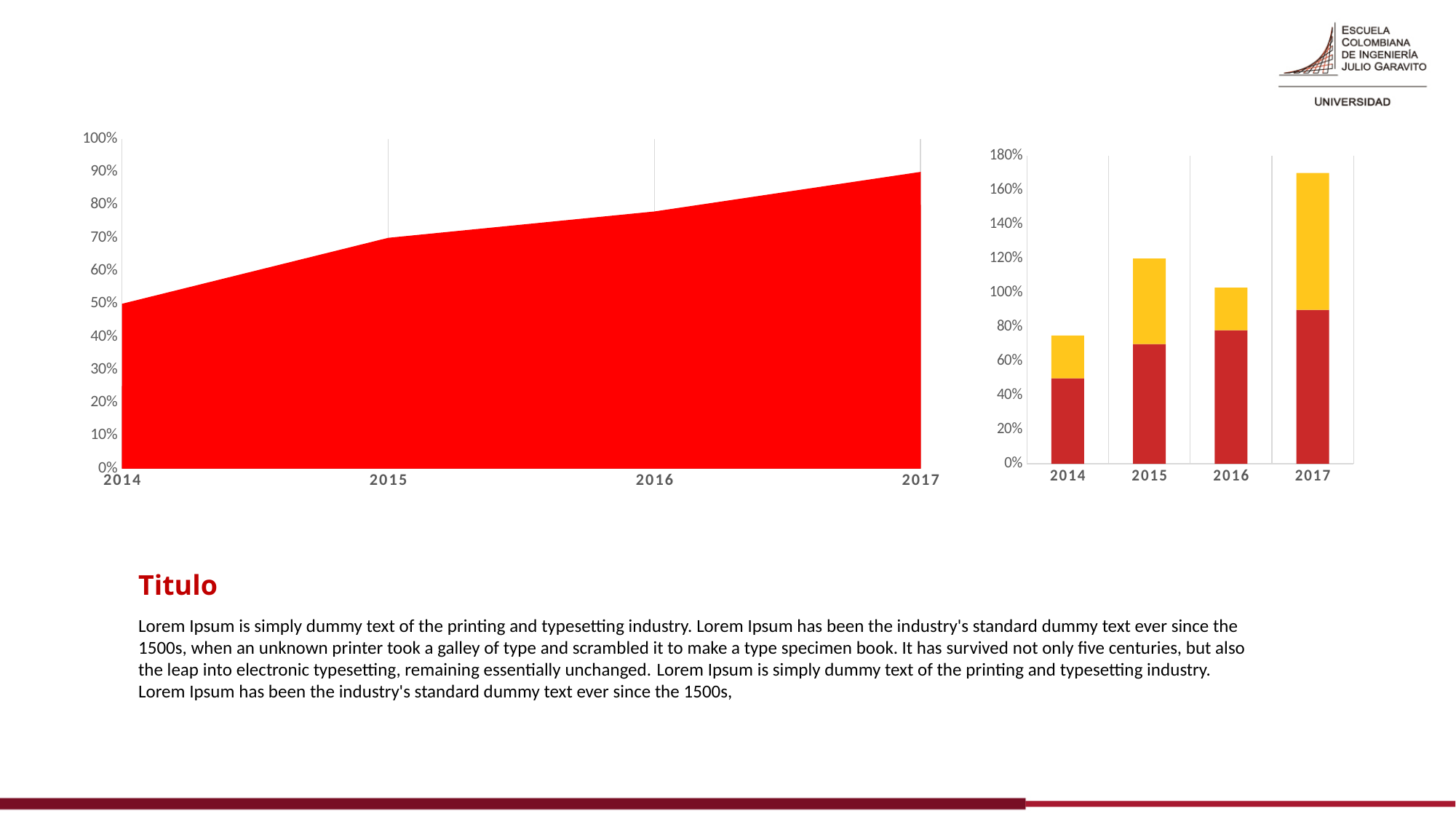
In the left area chart, is the value for 2015 greater or less than 80%? less In the right stacked bar chart, which bar is taller, 2015 or 2016? 2015 How many years are shown on the x axis of the left area chart? 4 What kind of chart is the chart on the left of the slide? area chart In the left area chart, is the value for 2017 greater or less than 80%? greater In the left area chart, do the values rise or fall from 2014 to 2017? rise How many bars are there in the right stacked bar chart? 4 In the right stacked bar chart, which year has the shortest bar? 2014 What kind of chart is the chart on the right of the slide? stacked bar chart In the left area chart, is the value for 2014 greater or less than 40%? greater In the right stacked bar chart, which year has the tallest bar? 2017